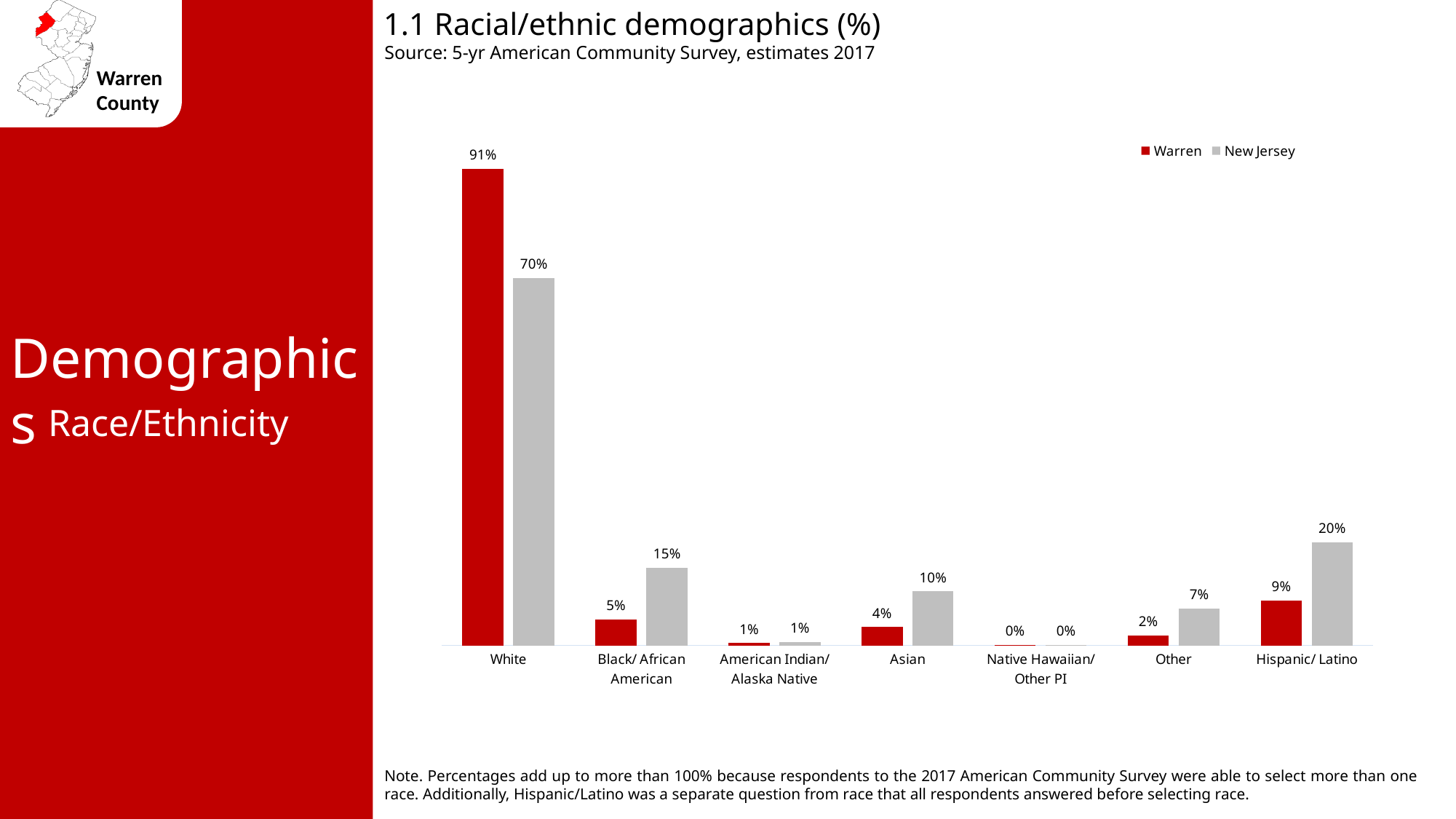
How many series does the legend list? 2 Which category has the highest Warren value? White What is the difference between the Warren and New Jersey values for White? 21% How many categories are shown on the x axis? 7 What is the Warren value for White? 91% Which is larger for Other, the Warren value or the New Jersey value? New Jersey What is the Warren value for Black/ African American? 5% What is the difference between the New Jersey and Warren values for Hispanic/ Latino? 11% Which category has the lowest New Jersey value? Native Hawaiian/ Other PI What kind of chart is shown on the slide? Bar chart What is the New Jersey value for Hispanic/ Latino? 20% What is the New Jersey value for Asian? 10%